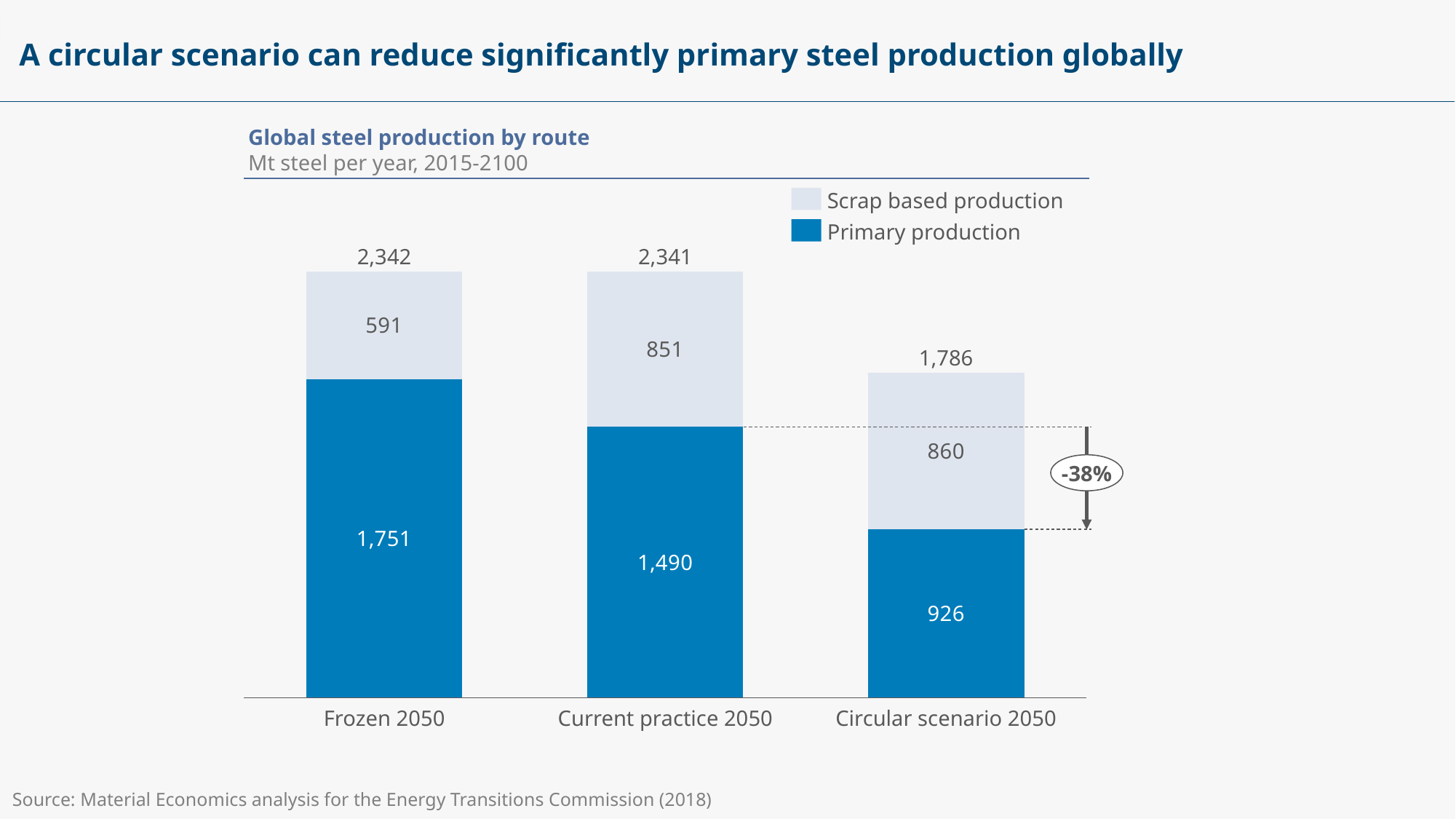
What is the primary production value for Circular scenario 2050? 926 What is the difference in primary production between Current practice 2050 and Circular scenario 2050? 564 What is the scrap based production value for Current practice 2050? 851 What type of chart is shown? Stacked bar chart How many scenarios are shown on the x axis? 3 What is the primary production value for Frozen 2050? 1,751 How many series does the legend list? 2 Which scenario has the highest primary production? Frozen 2050 What is the total steel production for Frozen 2050? 2,342 Which scenario has the lowest scrap based production? Frozen 2050 Is primary production larger for Frozen 2050 or Current practice 2050? Frozen 2050 What is the total steel production for Circular scenario 2050? 1,786